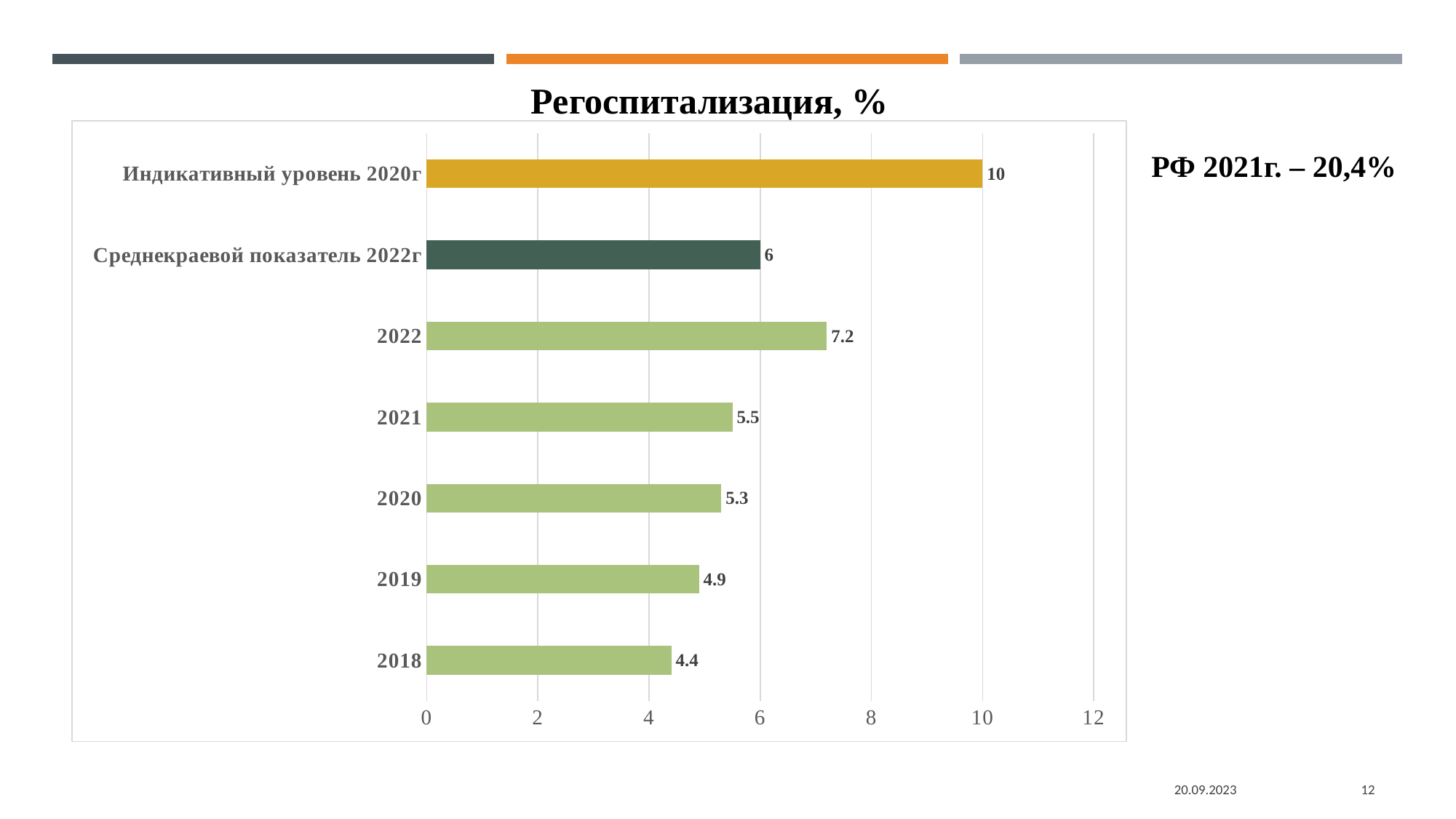
What kind of chart is shown on the slide? bar chart What is the difference between the values for 2022 and 2021? 1.7 What is the title of the chart? Регоспитализация, % Which category has the lowest value? 2018 Which is larger, the value for 2020 or the value for 2019? 2020 What is the value for Индикативный уровень 2020г? 10 What is the value for 2022? 7.2 How many bars are shown in the chart? 7 Which category has the highest value? Индикативный уровень 2020г What is the value for Среднекраевой показатель 2022г? 6 Is the value for 2021 greater or less than 6? less What is the value for 2018? 4.4